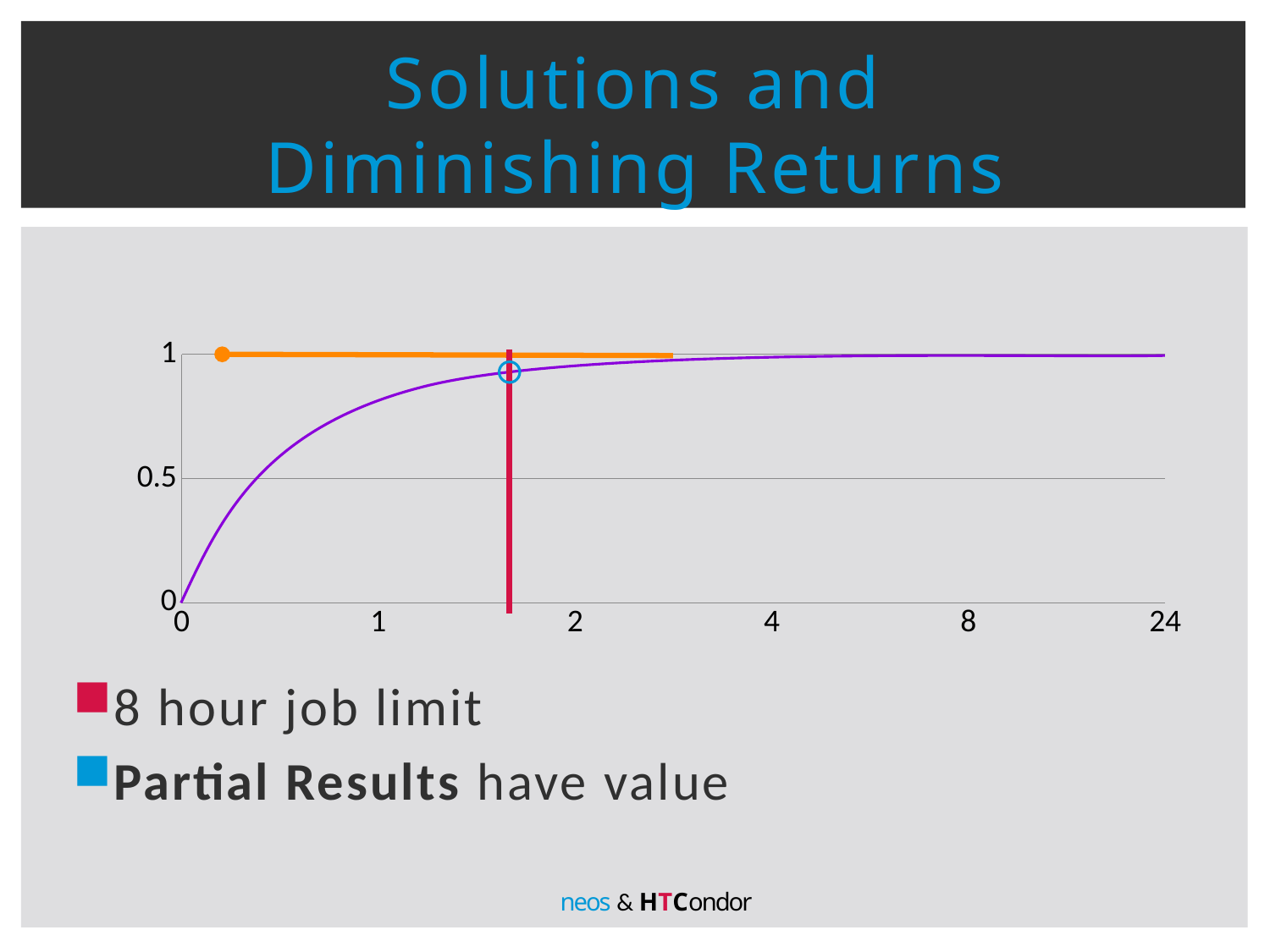
Is the value of the purple curve at x = 2 greater or less than 0.5? greater Does the purple curve rise or fall as the x axis increases from 0 to 24? rise At what y value does the orange horizontal line sit? 1 What is the title of the slide containing the chart? Solutions and Diminishing Returns Is the value of the purple curve at x = 8 greater or less than 0.5? greater Is the value of the purple curve at x = 1 greater or less than 0.5? greater What colour is the vertical line drawn between x = 1 and x = 2? red What is the highest tick label shown on the y axis? 1 What kind of chart is shown on the slide? line chart How many tick labels are shown on the x axis? 6 What is the highest tick label shown on the x axis? 24 What is the value of the purple curve at x = 0? 0